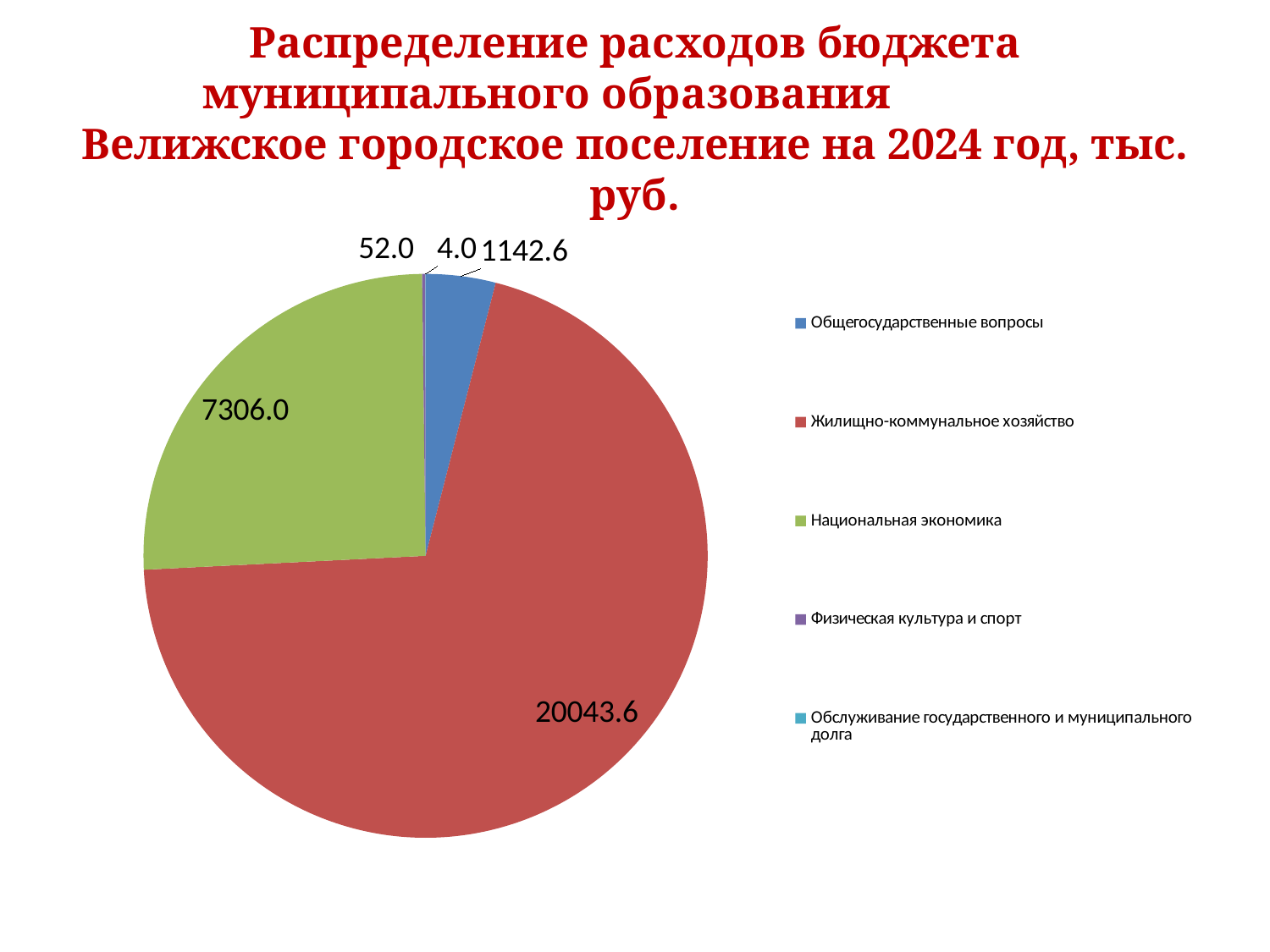
How many entries does the legend list? 5 What is the smallest value labelled on the pie chart? 4.0 What is the value for Жилищно-коммунальное хозяйство? 20043.6 What is the difference between the values for Жилищно-коммунальное хозяйство and Национальная экономика? 12737.6 What is the value for Общегосударственные вопросы? 1142.6 What type of chart is shown on the slide? pie chart What is the value for Национальная экономика? 7306.0 What colour is the slice for Национальная экономика? green What is the difference between the values for Национальная экономика and Общегосударственные вопросы? 6163.4 Which is larger, the value for Национальная экономика or the value for Общегосударственные вопросы? Национальная экономика Which category has the largest share of the pie? Жилищно-коммунальное хозяйство What is the total of all the values labelled on the pie chart? 28548.2